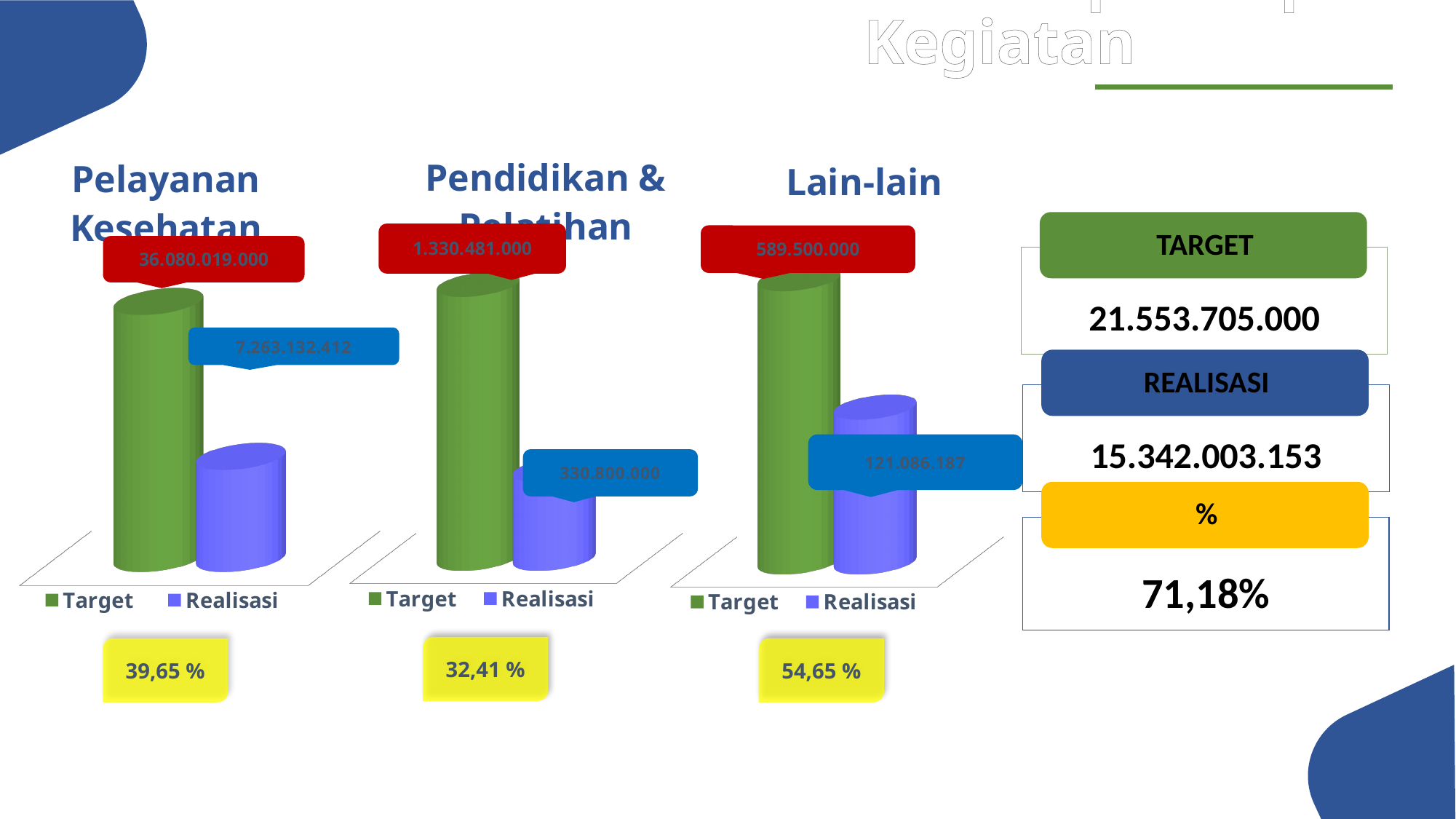
In the Lain-lain chart, what colour is the Target bar? Green What kind of chart is the Pendidikan & Pelatihan chart? Bar chart How many series does the legend of the Pelayanan Kesehatan chart list? 2 In the Pendidikan & Pelatihan chart, what is the value of the Realisasi bar? 330.800.000 In the Pendidikan & Pelatihan chart, what is the value of the Target bar? 1.330.481.000 In the Lain-lain chart, which is larger, Target or Realisasi? Target In the Lain-lain chart, what is the value of the Target bar? 589.500.000 In the Pelayanan Kesehatan chart, what is the value of the Target bar? 36.080.019.000 In the Lain-lain chart, what is the value of the Realisasi bar? 121.086.187 In the Pelayanan Kesehatan chart, what is the value of the Realisasi bar? 7.263.132.412 In the Lain-lain chart, what is the difference between the Target and Realisasi values? 468.413.813 In the Pendidikan & Pelatihan chart, what is the difference between the Target and Realisasi values? 999.681.000